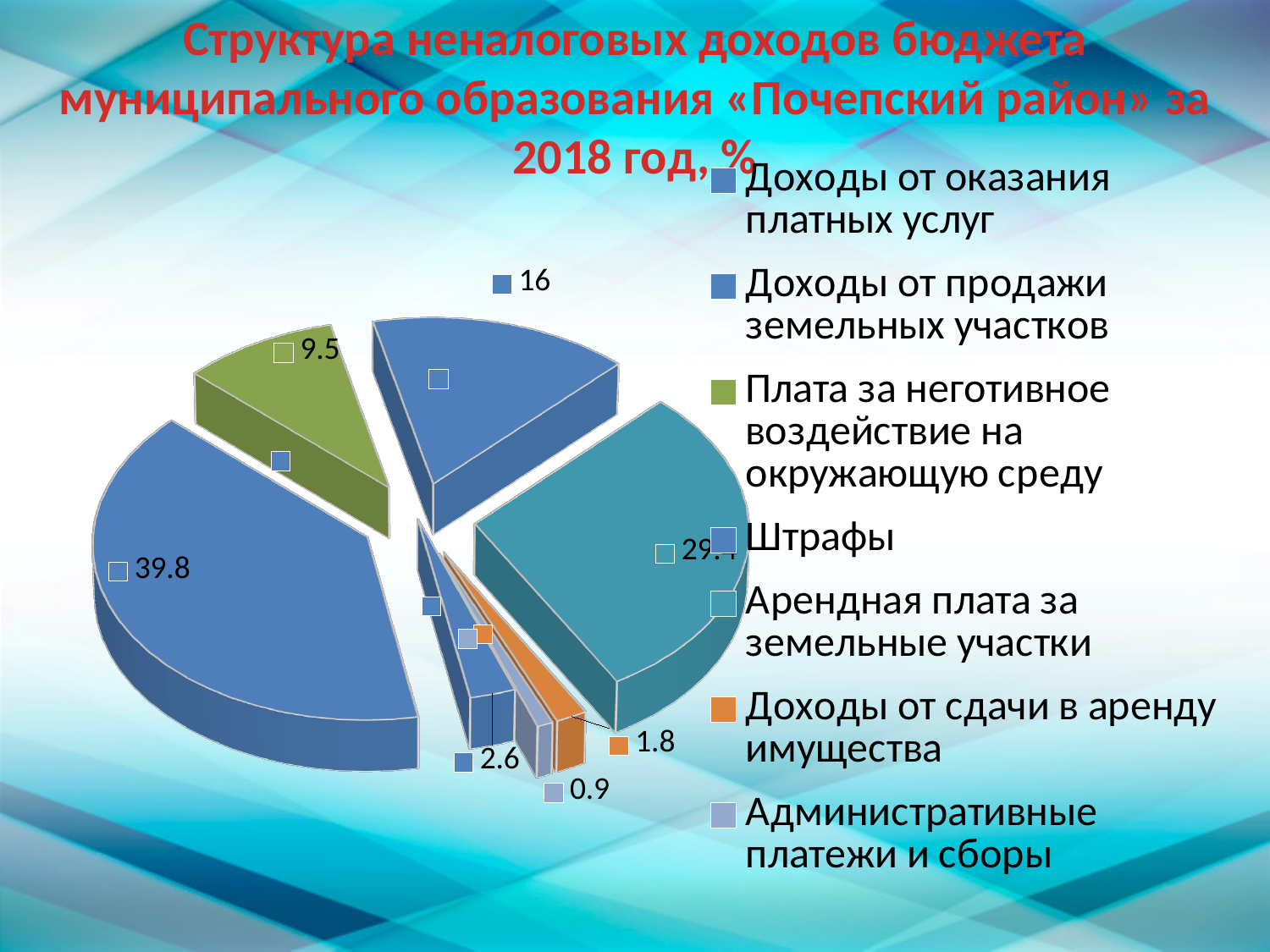
What colour is the slice for «Доходы от сдачи в аренду имущества»? orange What is the difference between the slice labelled 2.6 and the slice labelled 0.9? 1.7 What value is shown for the green slice, «Плата за неготивное воздействие на окружающую среду»? 9.5 What kind of chart is shown on the slide? pie chart Which is larger: the slice labelled 16 or the green slice labelled 9.5? the slice labelled 16 How many entries does the legend list? 7 What is the smallest value shown on the pie chart? 0.9 What is the difference between the two largest slices, 39.8 and 29.4? 10.4 What year does the chart title say the data is for? 2018 What is the largest value shown on the pie chart? 39.8 What value is shown for the orange slice, «Доходы от сдачи в аренду имущества»? 1.8 How many slices does the pie chart have? 7